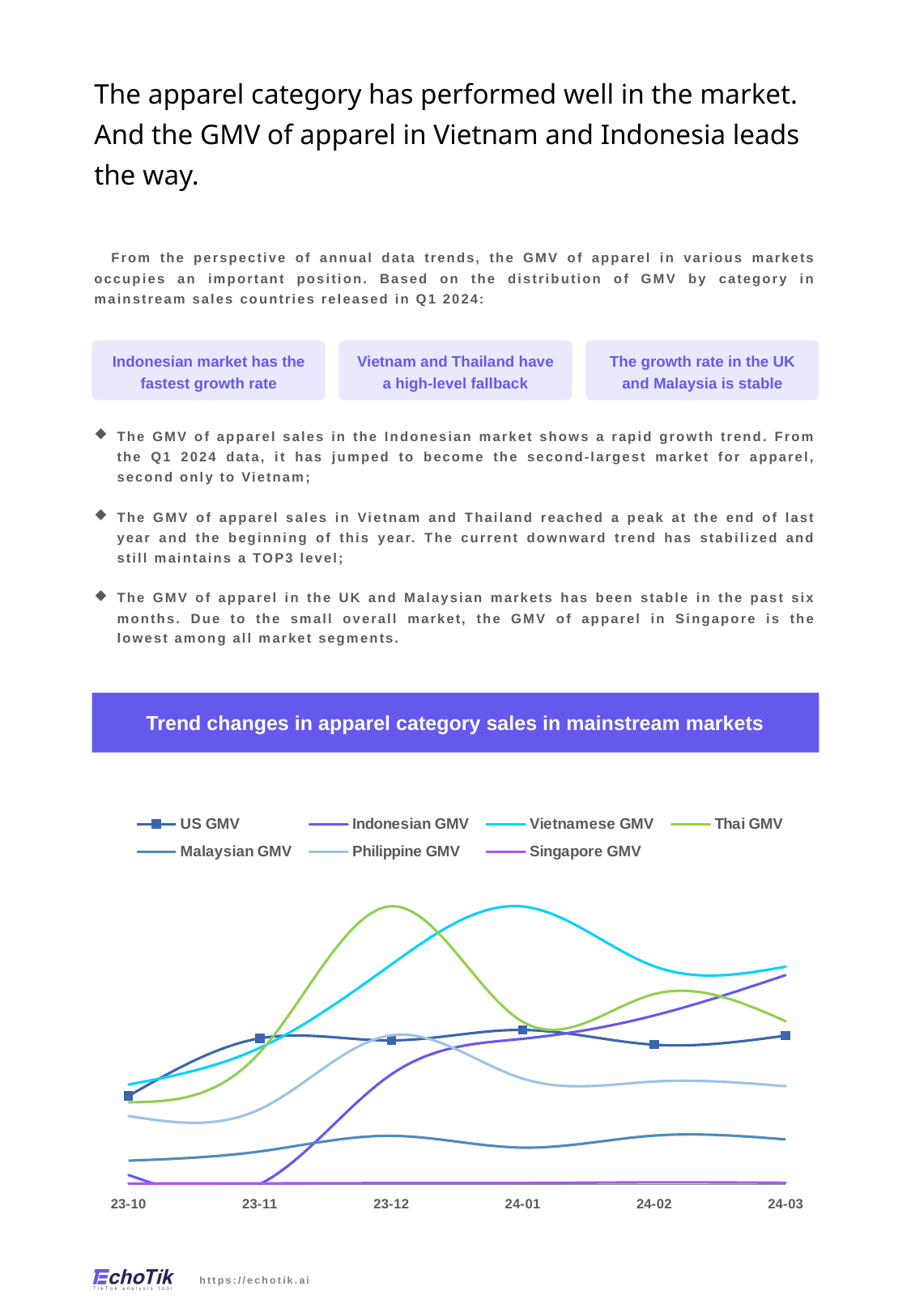
At 24-03, which is larger: Vietnamese GMV or Thai GMV? Vietnamese GMV At 24-03, which is larger: Indonesian GMV or US GMV? Indonesian GMV Which series has the highest value at 23-12? Thai GMV How many time points are shown on the x axis of the chart? 6 How many series does the chart legend list? 7 Which series has the highest value at 24-01? Vietnamese GMV Which series in the chart is drawn with square markers? US GMV What is the title of the chart? Trend changes in apparel category sales in mainstream markets What kind of chart is shown on the slide? Line chart Does Thai GMV rise or fall from 23-12 to 24-01? Fall Does Indonesian GMV rise or fall from 23-10 to 24-03? Rise